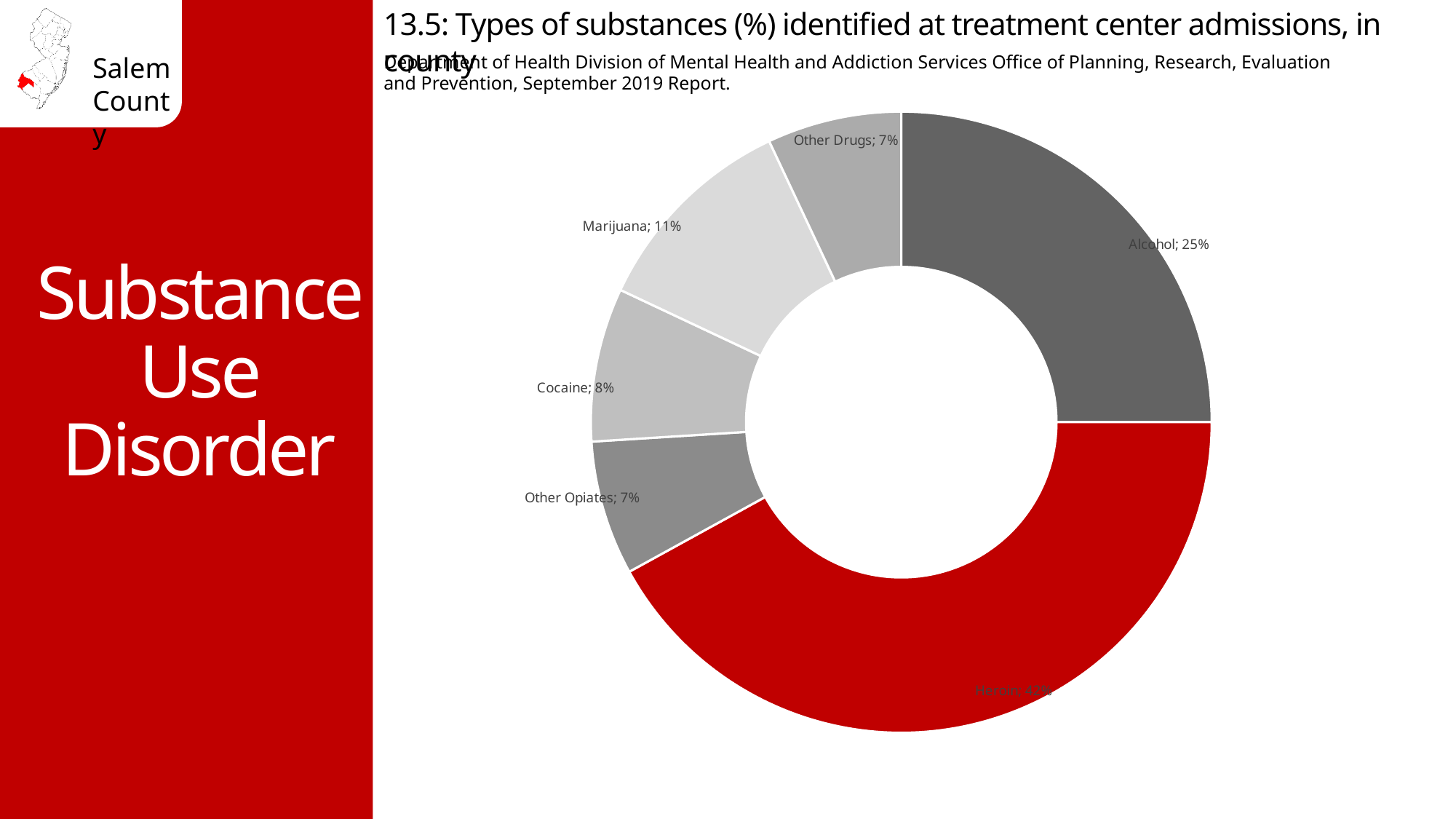
Which slice of the chart is coloured red? Heroin What is the difference in percentage points between Heroin and Alcohol? 17 What is the figure number given in the chart title? 13.5 What kind of chart is used on this slide? Doughnut (pie) chart What percentage of treatment center admissions is attributed to Alcohol? 25% Which substance has the largest share of treatment center admissions? Heroin What percentage is shown for Marijuana? 11% What percentage is shown for Cocaine? 8% How many substance categories are shown in the chart? 6 What is the combined percentage for Other Opiates and Other Drugs? 14% What percentage of treatment center admissions is attributed to Heroin? 42% Which is larger, the share for Marijuana or the share for Cocaine? Marijuana